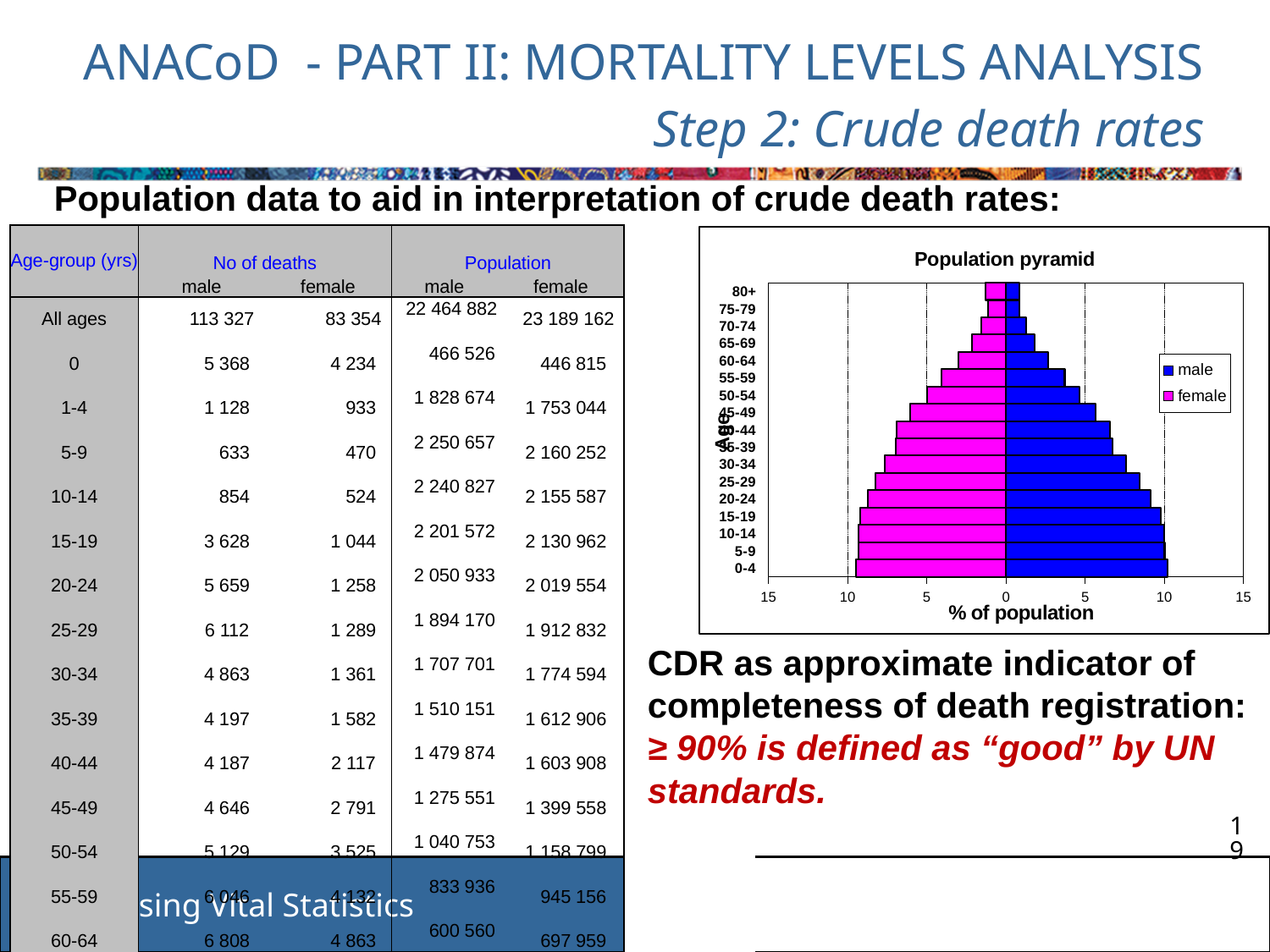
In the Population pyramid, which age group has the largest share of the male population? 0-4 In the Population pyramid, do the bar lengths generally rise or fall as age increases from 0-4 to 80+? fall In the Population pyramid, is the male value for the 80+ age group greater or less than 5? less What is the x-axis label of the Population pyramid? % of population How many series does the legend of the Population pyramid list? 2 How many age groups are shown on the Population pyramid? 17 In the Population pyramid, which is larger: the male share for 0-4 or the male share for 60-64? 0-4 What kind of chart is the Population pyramid? bar chart In the Population pyramid, is the male value for the 40-44 age group greater or less than 5? greater What is the title of the chart on the slide? Population pyramid In the Population pyramid, which age group has the largest share of the female population? 0-4 In the Population pyramid, is the female value for the 60-64 age group greater or less than 5? less